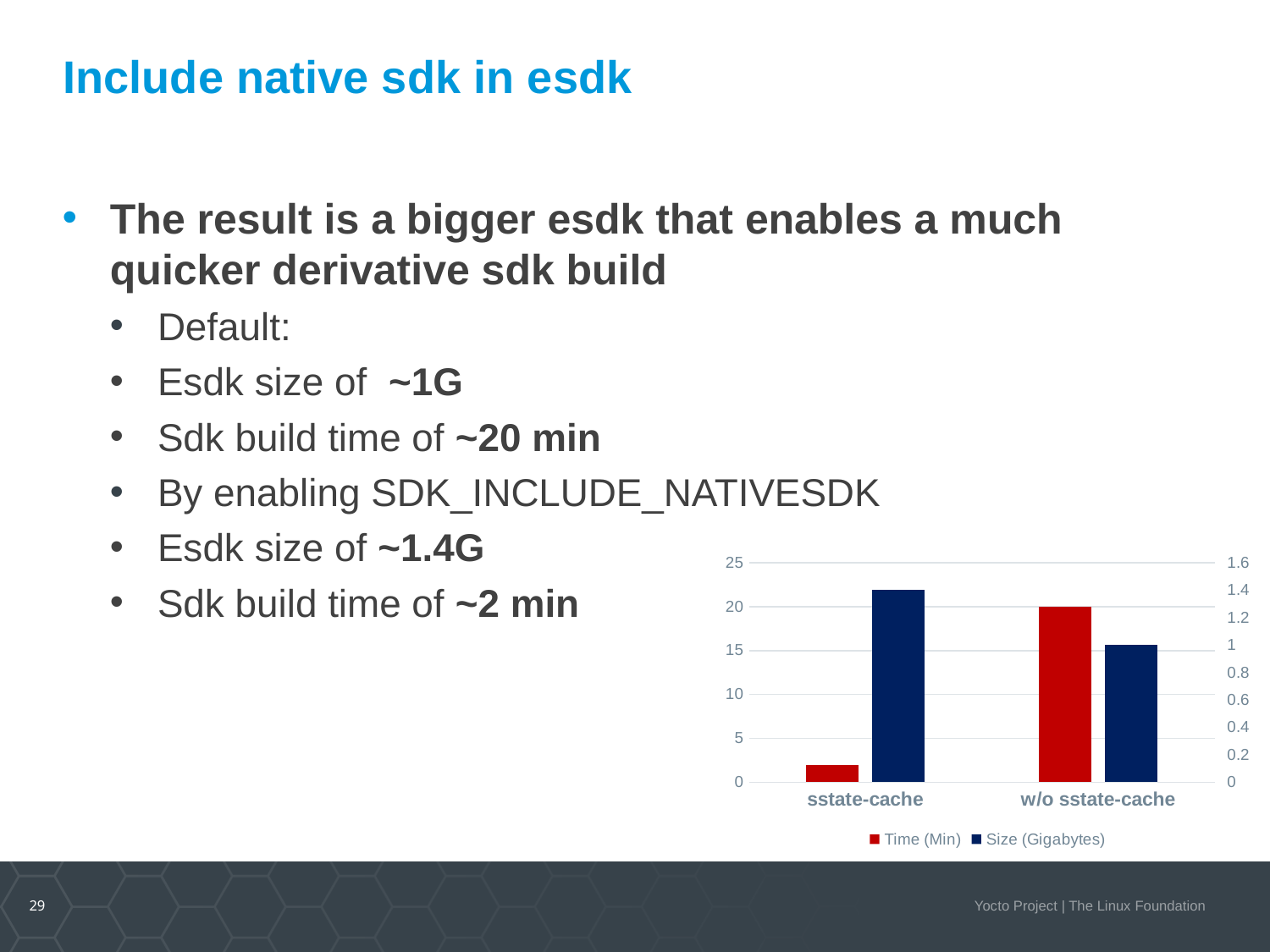
What kind of chart is shown on the slide? bar chart How many categories are shown on the x axis of the chart? 2 Which category has the lower Time (Min) value in the chart? sstate-cache Is the Size (Gigabytes) value for w/o sstate-cache greater or less than 0.8? greater Is the Size (Gigabytes) value for sstate-cache greater or less than 1.2? greater Is the Time (Min) value for sstate-cache greater or less than 5? less How many series does the chart's legend list? 2 Which category has the higher Time (Min) value in the chart? w/o sstate-cache What is the highest tick value shown on the right-hand axis of the chart? 1.6 Which category has the larger Size (Gigabytes) value in the chart? sstate-cache Which series in the chart is drawn in red? Time (Min)